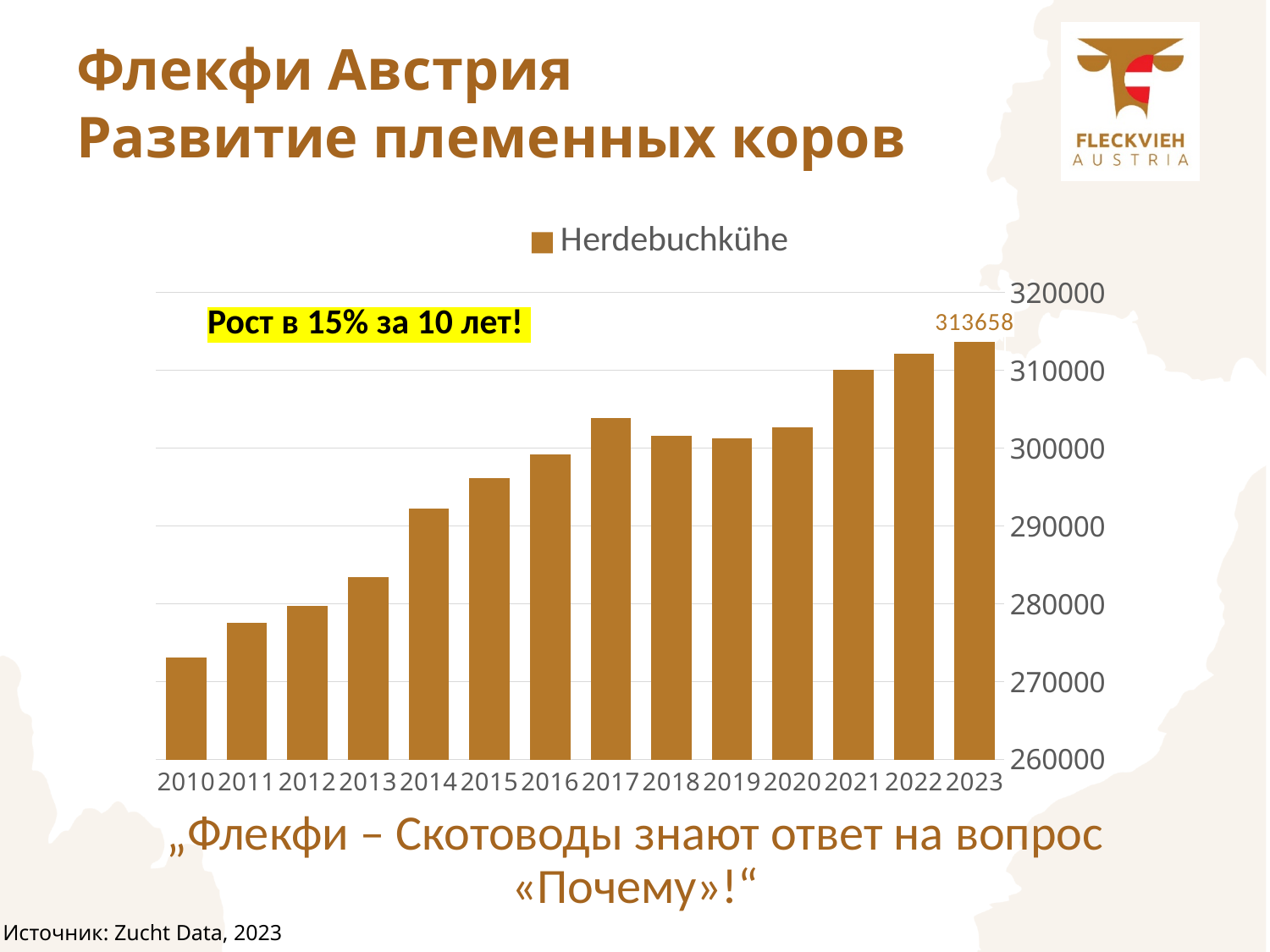
What is the name of the series shown in the legend? Herdebuchkühe What kind of chart is shown on the slide? Bar chart How many series does the legend list? 1 Which year has the lowest number of Herdebuchkühe? 2010 Which year has the highest number of Herdebuchkühe? 2023 Which is larger, the value for 2017 or the value for 2018? 2017 Is the value for 2010 greater or less than 270000? greater What is the value of the 2023 bar? 313658 Is the value for 2014 greater or less than 290000? greater Do the values generally rise or fall from 2010 to 2023? Rise How many years are shown on the x axis? 14